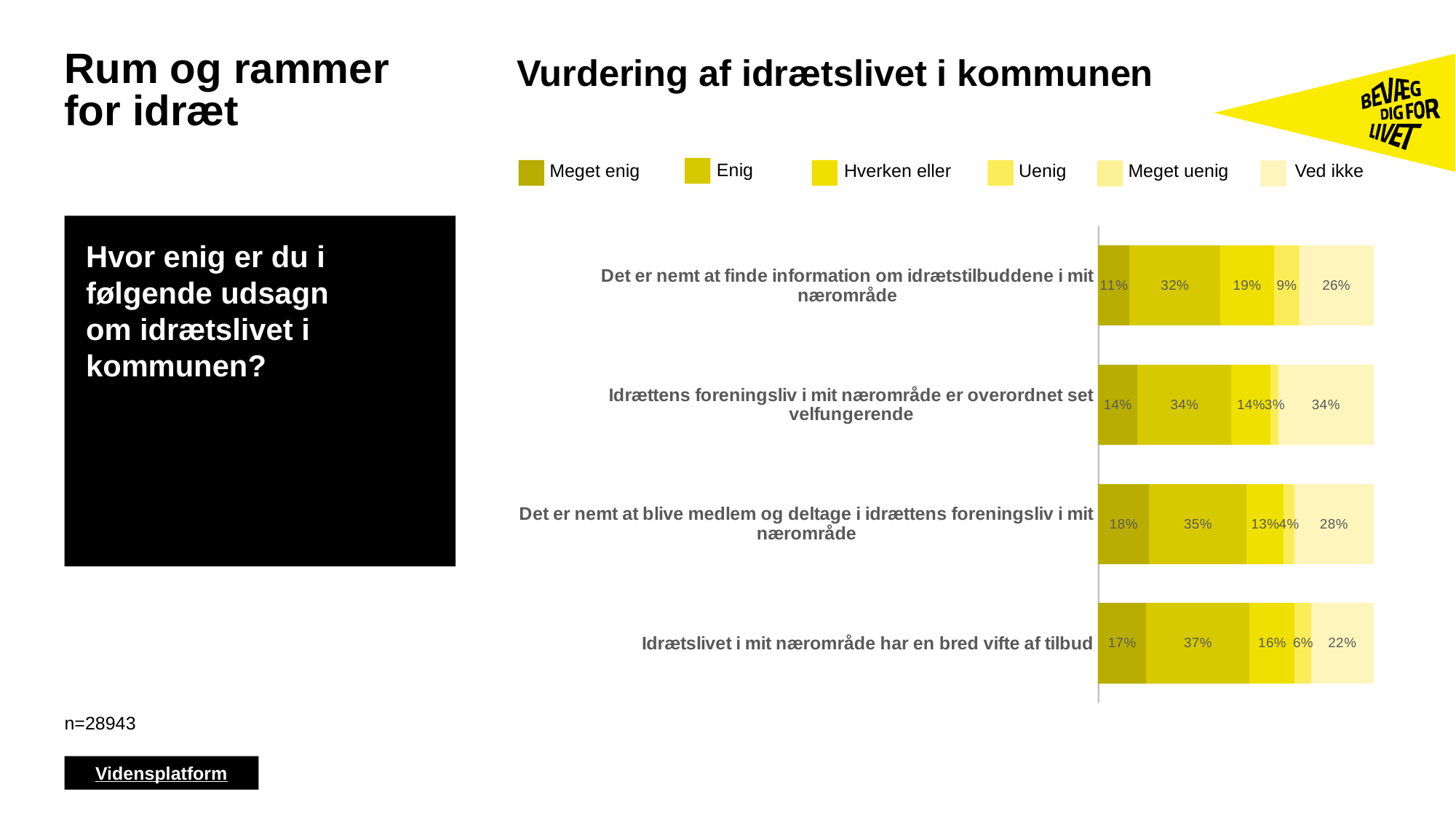
What is the 'Ved ikke' value for 'Idrættens foreningsliv i mit nærområde er overordnet set velfungerende'? 34% Which statement has the highest 'Meget enig' value? Det er nemt at blive medlem og deltage i idrættens foreningsliv i mit nærområde What is the title of the chart? Vurdering af idrætslivet i kommunen What is the difference between the 'Enig' values for 'Idrætslivet i mit nærområde har en bred vifte af tilbud' and 'Det er nemt at finde information om idrætstilbuddene i mit nærområde'? 5% Which statement has the lowest 'Ved ikke' value? Idrætslivet i mit nærområde har en bred vifte af tilbud How many statements (categories) are shown in the chart? 4 What is the 'Enig' value for 'Idrætslivet i mit nærområde har en bred vifte af tilbud'? 37% What is the 'Meget enig' value for 'Det er nemt at finde information om idrætstilbuddene i mit nærområde'? 11% What kind of chart is shown on the slide? stacked bar chart How many series does the legend list? 6 What is the 'Uenig' value for 'Det er nemt at blive medlem og deltage i idrættens foreningsliv i mit nærområde'? 4% Which is larger: the 'Hverken eller' value for 'Det er nemt at finde information om idrætstilbuddene i mit nærområde' or for 'Idrætslivet i mit nærområde har en bred vifte af tilbud'? Det er nemt at finde information om idrætstilbuddene i mit nærområde